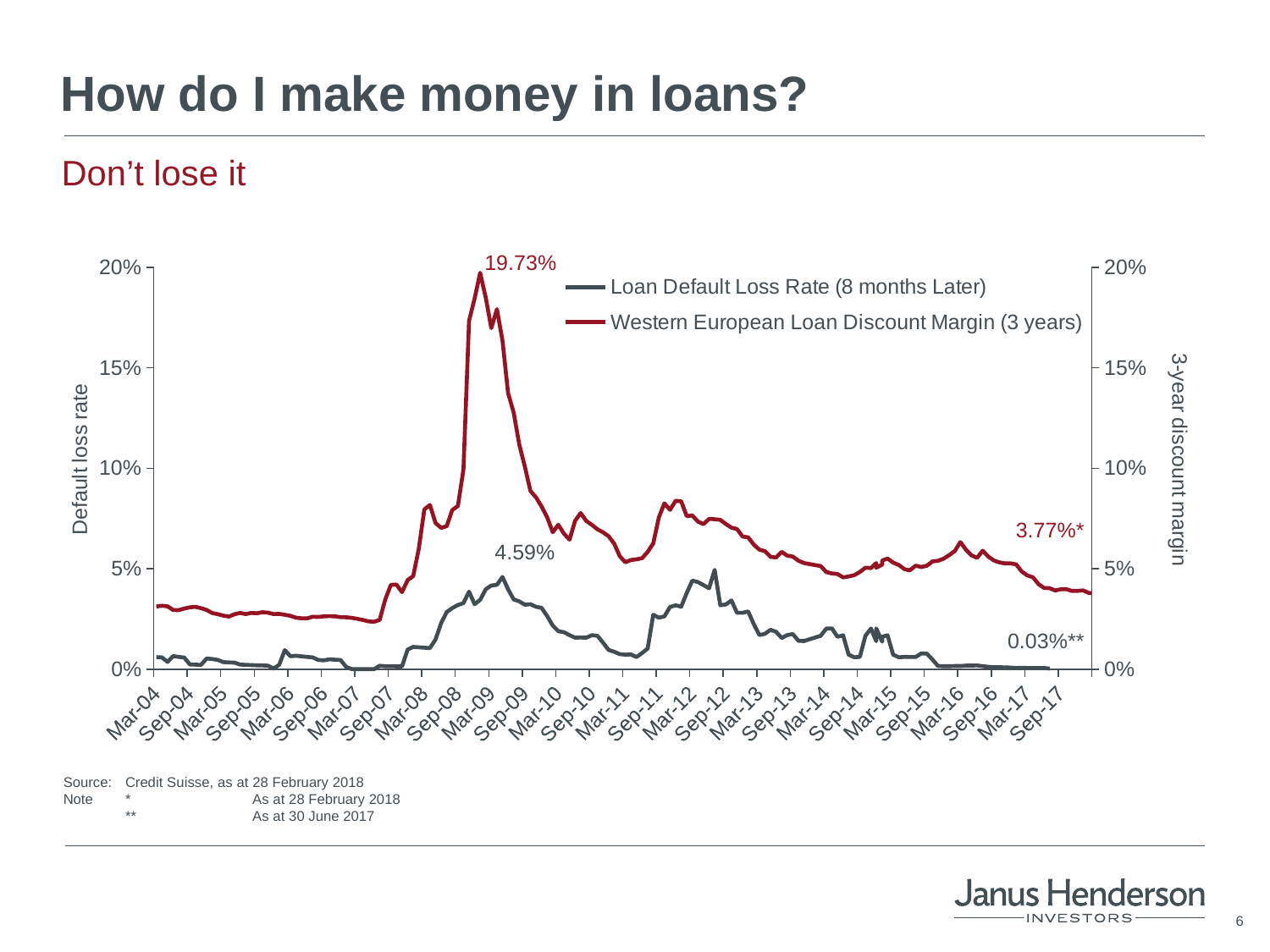
What is the difference between the latest labelled values 3.77% and 0.03%? 3.74% What is the peak value labelled on the Western European Loan Discount Margin (3 years) line? 19.73% Does the Loan Default Loss Rate line rise or fall between Sep-12 and Sep-17? fall What is the latest labelled value of the Western European Loan Discount Margin (3 years) line? 3.77% What is the peak value labelled on the Loan Default Loss Rate (8 months Later) line? 4.59% Which series reaches a higher peak, the Loan Default Loss Rate or the Western European Loan Discount Margin? Western European Loan Discount Margin (3 years) Is the value of the Western European Loan Discount Margin line at Mar-04 greater or less than 5%? less What is the latest labelled value of the Loan Default Loss Rate (8 months Later) line? 0.03% What is the title of the right-hand vertical axis? 3-year discount margin What kind of chart is shown on the slide? line chart How many series does the legend list? 2 What is the difference between the labelled peak of the Western European Loan Discount Margin (19.73%) and the labelled peak of the Loan Default Loss Rate (4.59%)? 15.14%